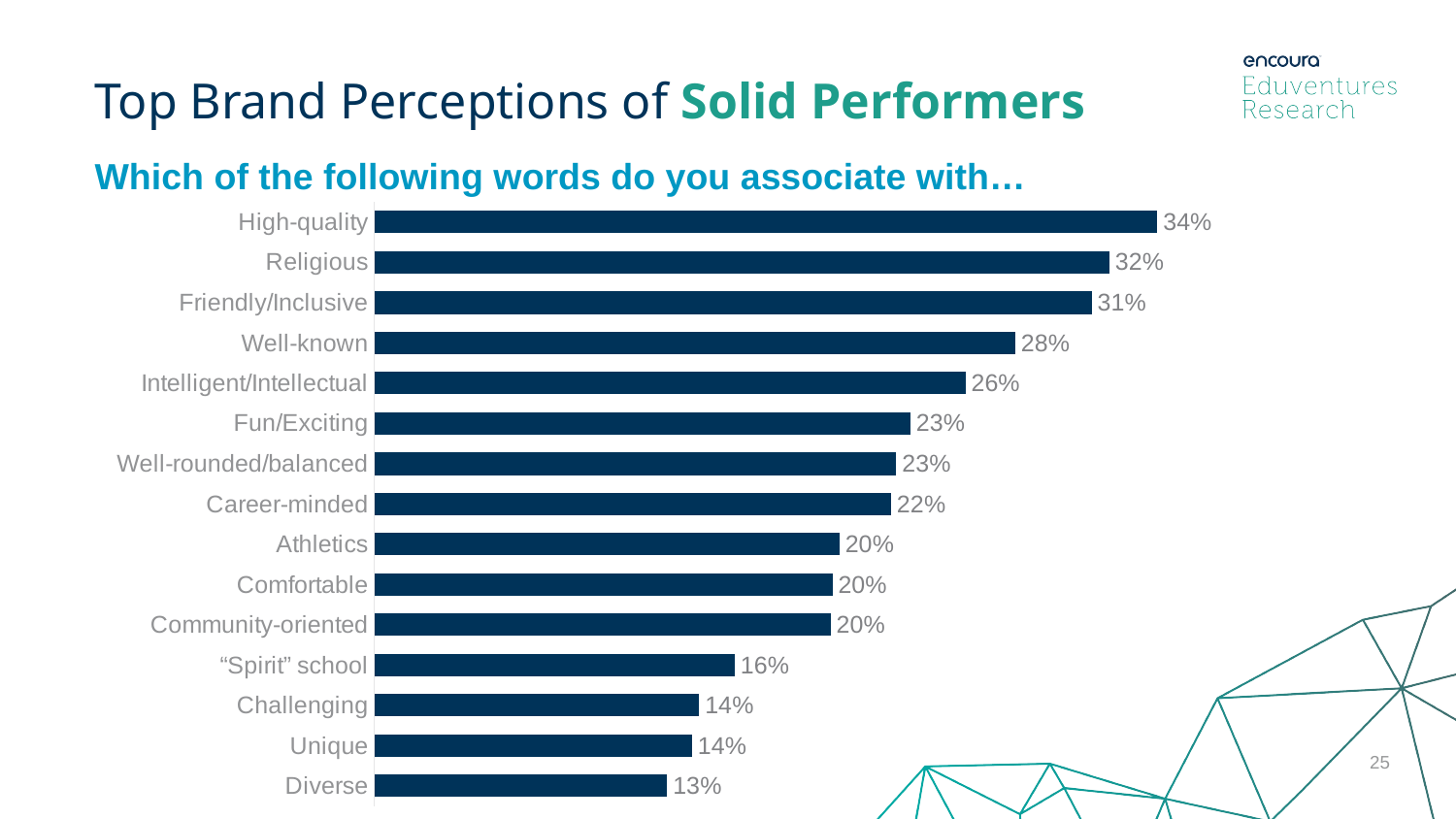
How many words (categories) are shown in the chart? 15 What percentage is shown for "Career-minded"? 22% What is the difference between the values for "Religious" and "Well-known"? 4% What percentage of respondents associate "High-quality" with Solid Performers? 34% What is the value shown for "Well-known"? 28% What type of chart is shown on the slide? Bar chart What is the difference between the percentages for "High-quality" and "Diverse"? 21% Which has a higher percentage, "Athletics" or "Challenging"? Athletics Which word has the highest percentage in the chart? High-quality Which word has the lowest percentage in the chart? Diverse Which has a higher percentage, "Friendly/Inclusive" or "Intelligent/Intellectual"? Friendly/Inclusive What question does the chart's subtitle ask? Which of the following words do you associate with…